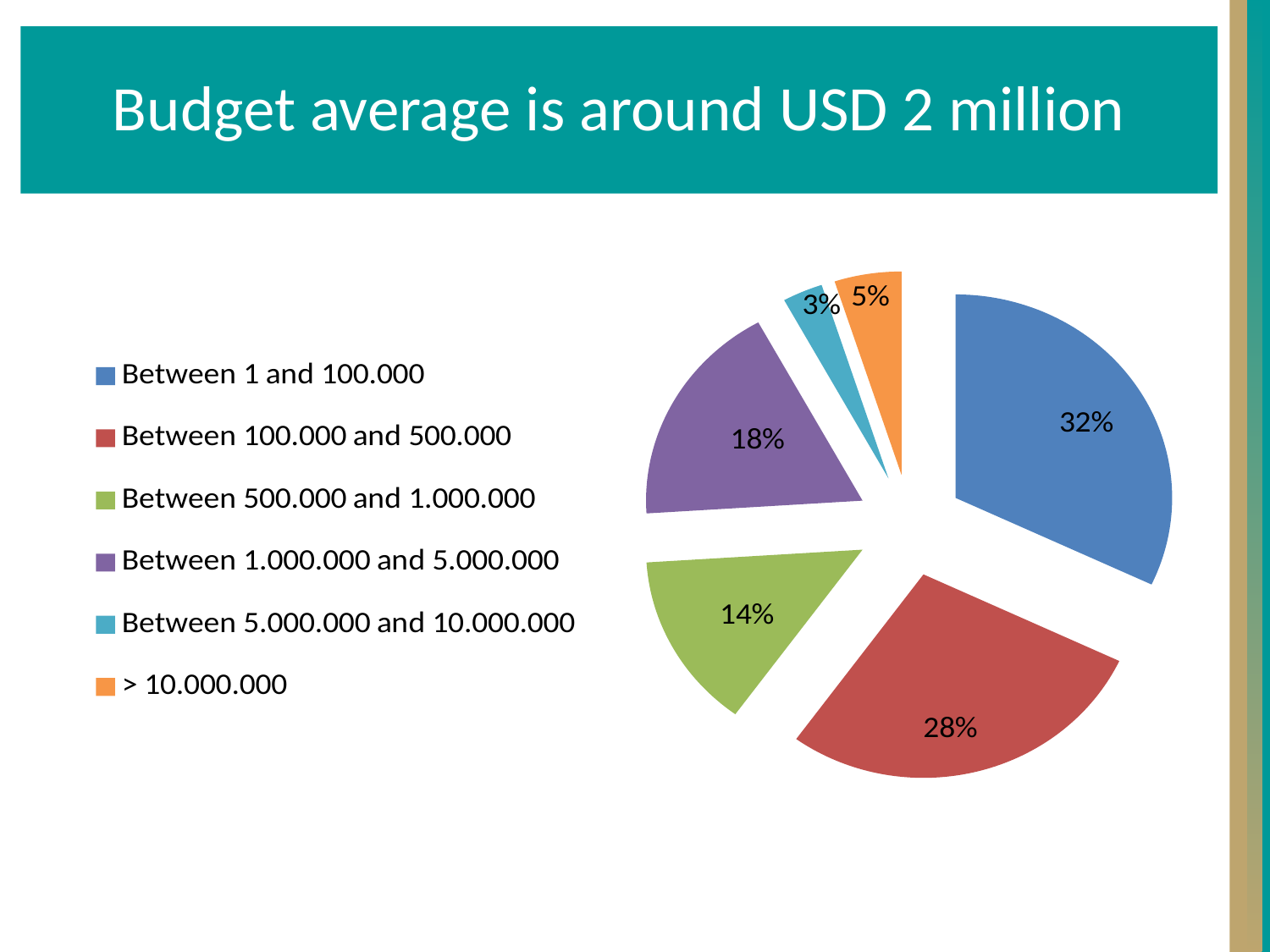
Which category has the smallest slice of the pie? Between 5.000.000 and 10.000.000 What share of the pie is the '> 10.000.000' slice? 5% What share of the pie is the 'Between 500.000 and 1.000.000' slice? 14% What share of the pie is the 'Between 100.000 and 500.000' slice? 28% Which is larger: the 'Between 500.000 and 1.000.000' slice or the 'Between 1.000.000 and 5.000.000' slice? Between 1.000.000 and 5.000.000 How many categories does the legend list? 6 What type of chart is shown on the slide? pie chart What is the difference in percentage points between the 'Between 1 and 100.000' slice and the 'Between 100.000 and 500.000' slice? 4 percentage points Which category has the largest slice of the pie? Between 1 and 100.000